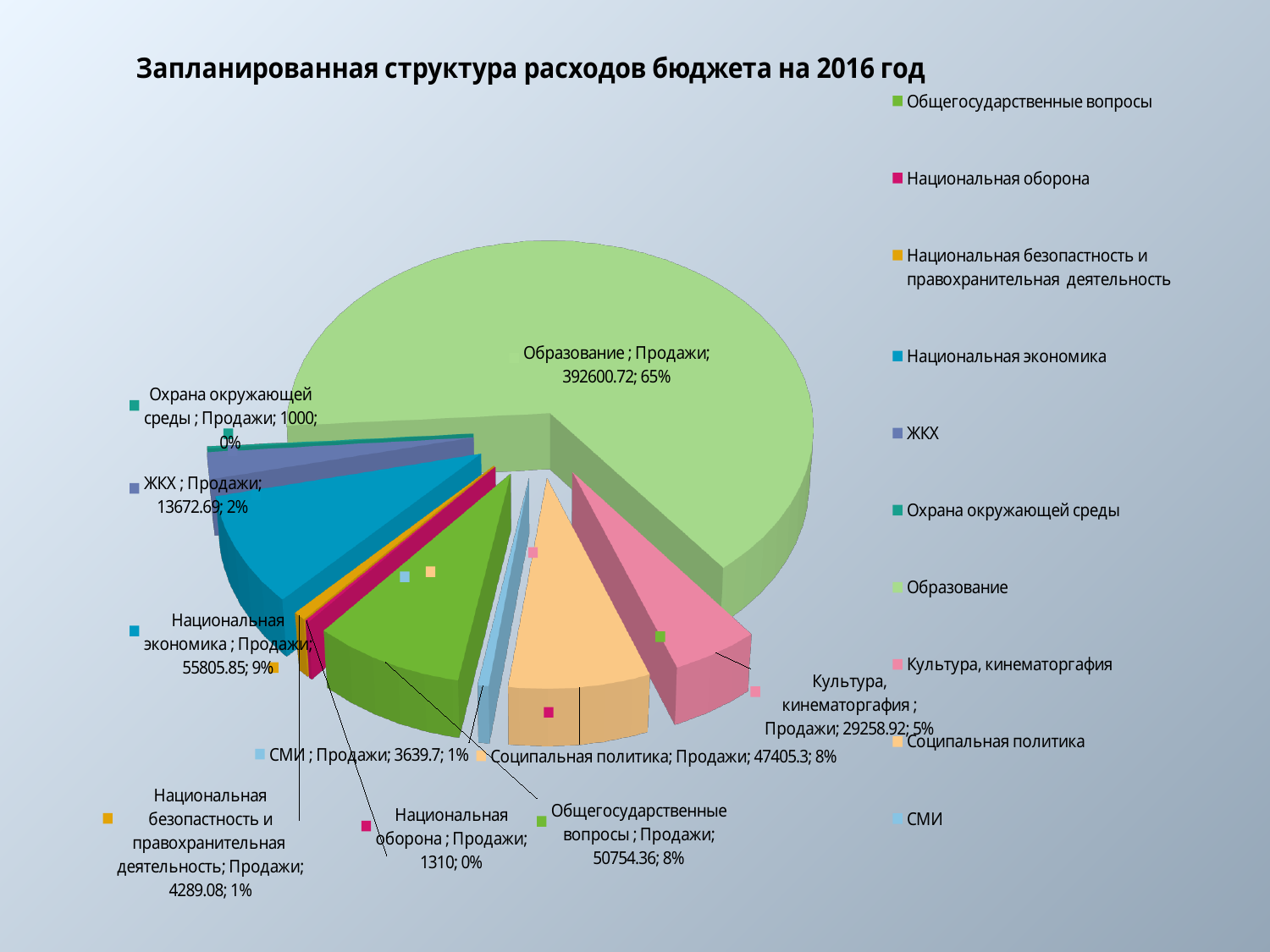
What is the title of the chart? Запланированная структура расходов бюджета на 2016 год What is the value shown for Образование? 392600.72 What is the value shown for Национальная экономика? 55805.85 What share of the pie does Соципальная политика represent? 8% Which is larger, the value for Национальная экономика or the value for Соципальная политика? Национальная экономика What is the difference between the values for Общегосударственные вопросы and Соципальная политика? 3349.06 What type of chart is shown on the slide? Pie chart How many categories does the legend list? 10 Which category has the largest slice of the pie? Образование What is the value shown for Культура, кинематоргафия? 29258.92 What share of the pie does Образование represent? 65% Which category has the smallest value in the chart? Охрана окружающей среды